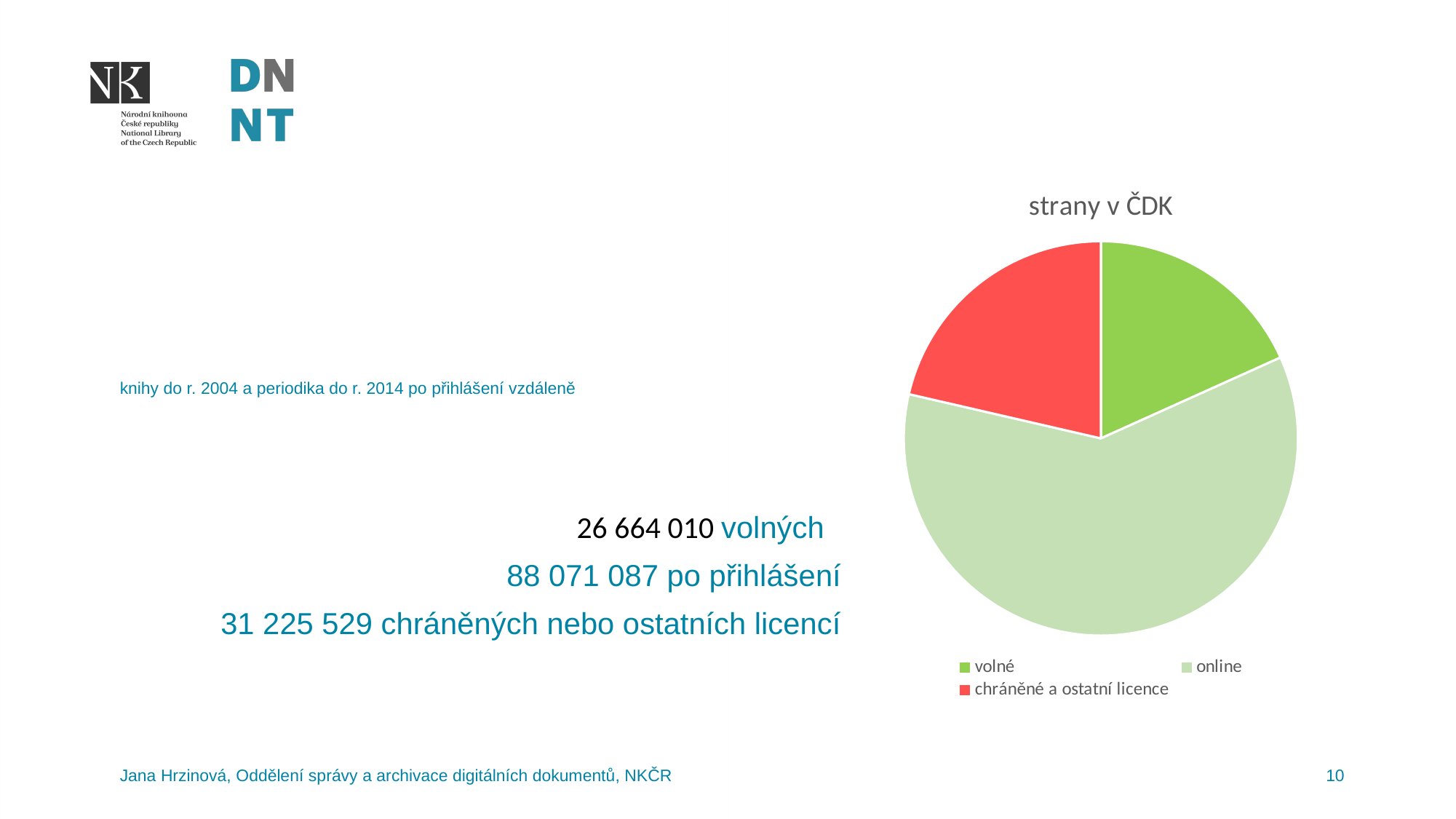
Does the volné slice account for more or less than half of the pie? less Which legend entry is shown in red? chráněné a ostatní licence What kind of chart is shown on the slide? pie chart Does the online slice account for more or less than half of the pie? more Which slice is larger, online or chráněné a ostatní licence? online How many entries does the chart legend list? 3 What is the title of the chart? strany v ČDK Which slice is larger, online or volné? online How many slices does the pie chart have? 3 Which category has the largest slice of the pie? online